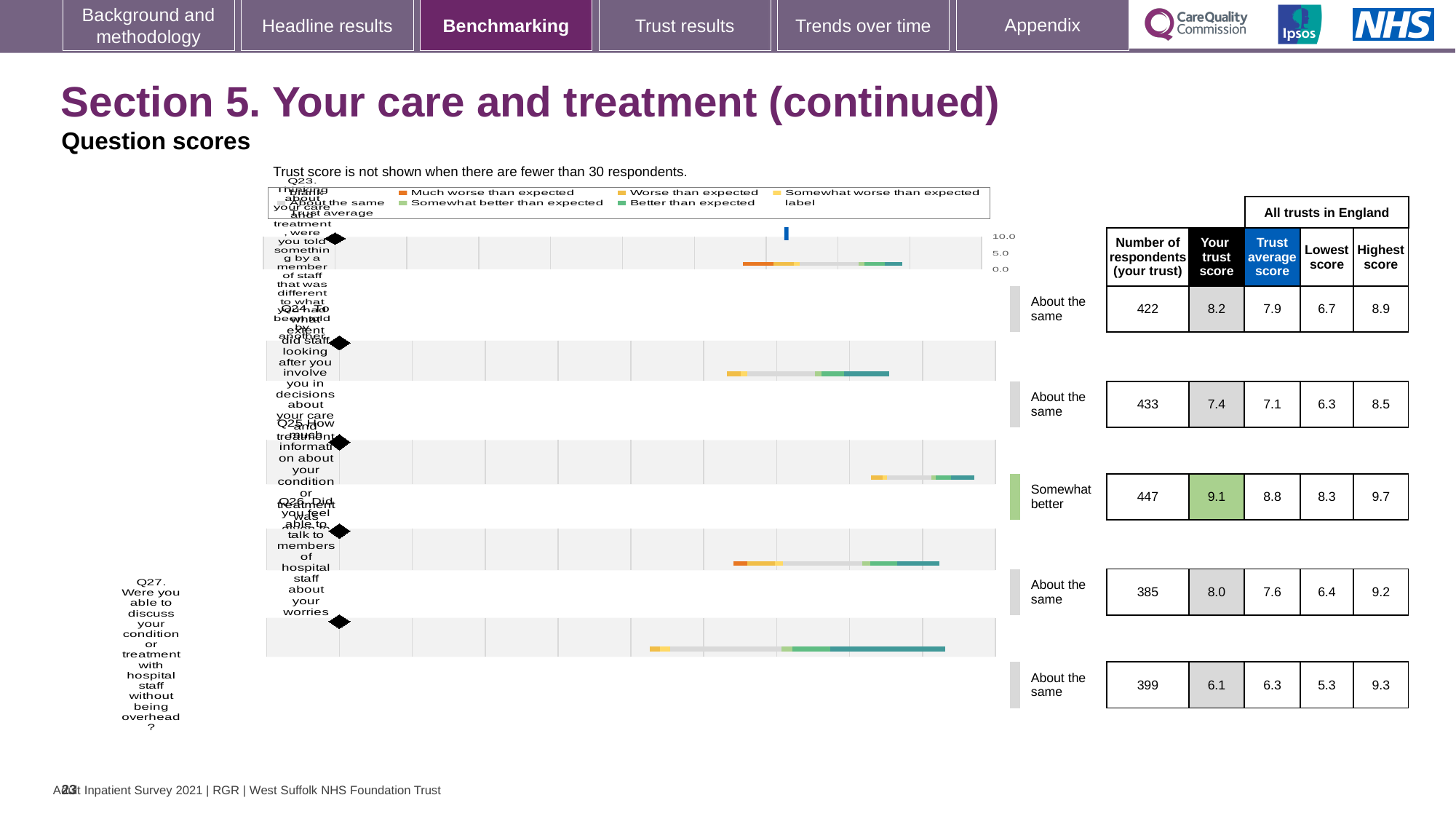
What type of chart is used to show the question scores on this slide? bar chart Which question has the highest 'Your trust score'? Q25 What is the 'Your trust score' value for Q25? 9.1 What is the highest score across all trusts in England for Q27? 9.3 What is the difference between the trust score and the trust average score for Q25? 0.3 What is the lowest score across all trusts in England for Q23? 6.7 How many of the five questions are rated 'About the same'? 4 For Q27, which is larger: the trust score or the trust average score? Trust average score Which question has the lowest 'Your trust score'? Q27 What is the number of respondents for Q24? 433 What benchmark category is shown for Q25? Somewhat better How many questions (rows) are shown in the question scores chart? 5